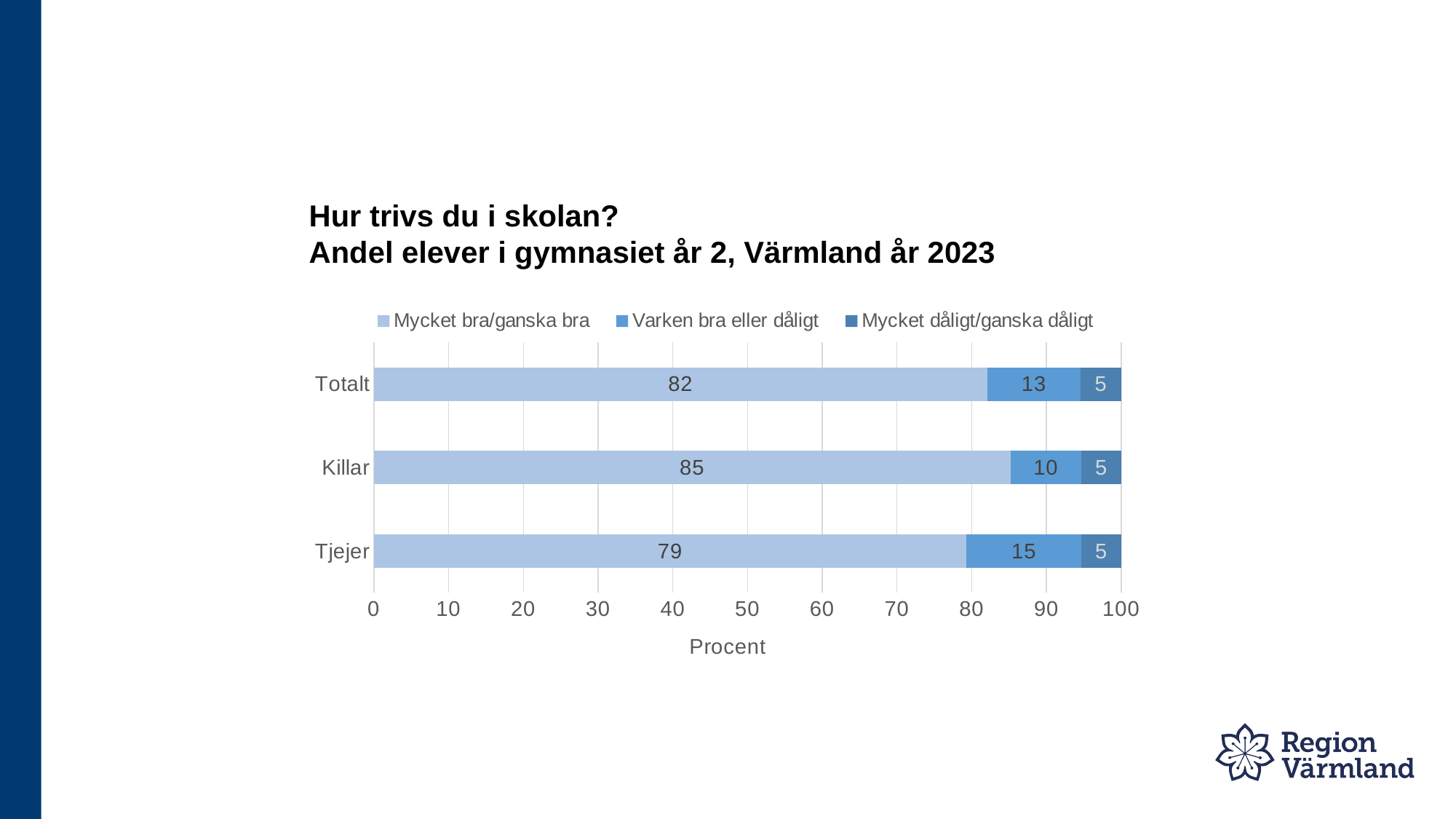
Which is larger: the 'Varken bra eller dåligt' value for Tjejer or for Totalt? Tjejer What is the total of the stacked bar for Tjejer? 99 How many categories are shown on the y axis? 3 Which category has the lowest value for 'Varken bra eller dåligt'? Killar How many series does the legend list? 3 What is the value for 'Mycket bra/ganska bra' for Totalt? 82 What is the value for 'Varken bra eller dåligt' for Tjejer? 15 Which category has the highest value for 'Mycket bra/ganska bra'? Killar What kind of chart is shown? Stacked bar chart What is the value for 'Mycket dåligt/ganska dåligt' for Killar? 5 What is the label of the x axis? Procent What is the difference between the 'Mycket bra/ganska bra' values for Killar and Tjejer? 6